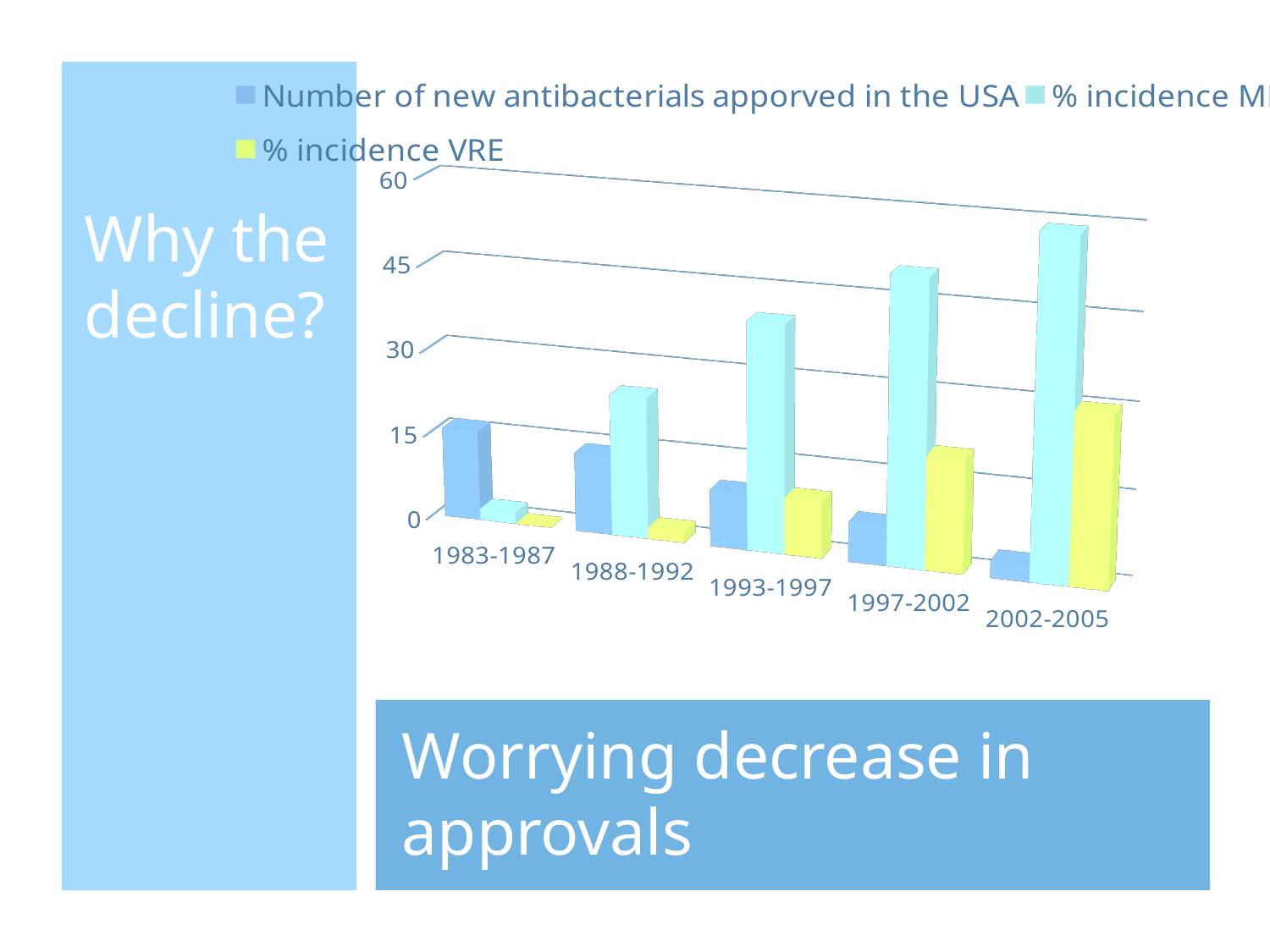
Does the '% incidence VRE' series rise or fall from 1983-1987 to 2002-2005? rise In which period is '% incidence VRE' highest? 2002-2005 In which period is the 'Number of new antibacterials apporved in the USA' highest? 1983-1987 What is the first time period shown on the x axis of the chart? 1983-1987 In which period is the 'Number of new antibacterials apporved in the USA' lowest? 2002-2005 How many time-period categories are shown on the x axis of the chart? 5 Is the value for 'Number of new antibacterials apporved in the USA' in 1983-1987 greater or less than 30? less Does the 'Number of new antibacterials apporved in the USA' series rise or fall from 1983-1987 to 2002-2005? fall How many series does the chart's legend list? 3 In 2002-2005, which is larger: 'Number of new antibacterials apporved in the USA' or '% incidence VRE'? % incidence VRE What kind of chart is shown on the slide? bar chart